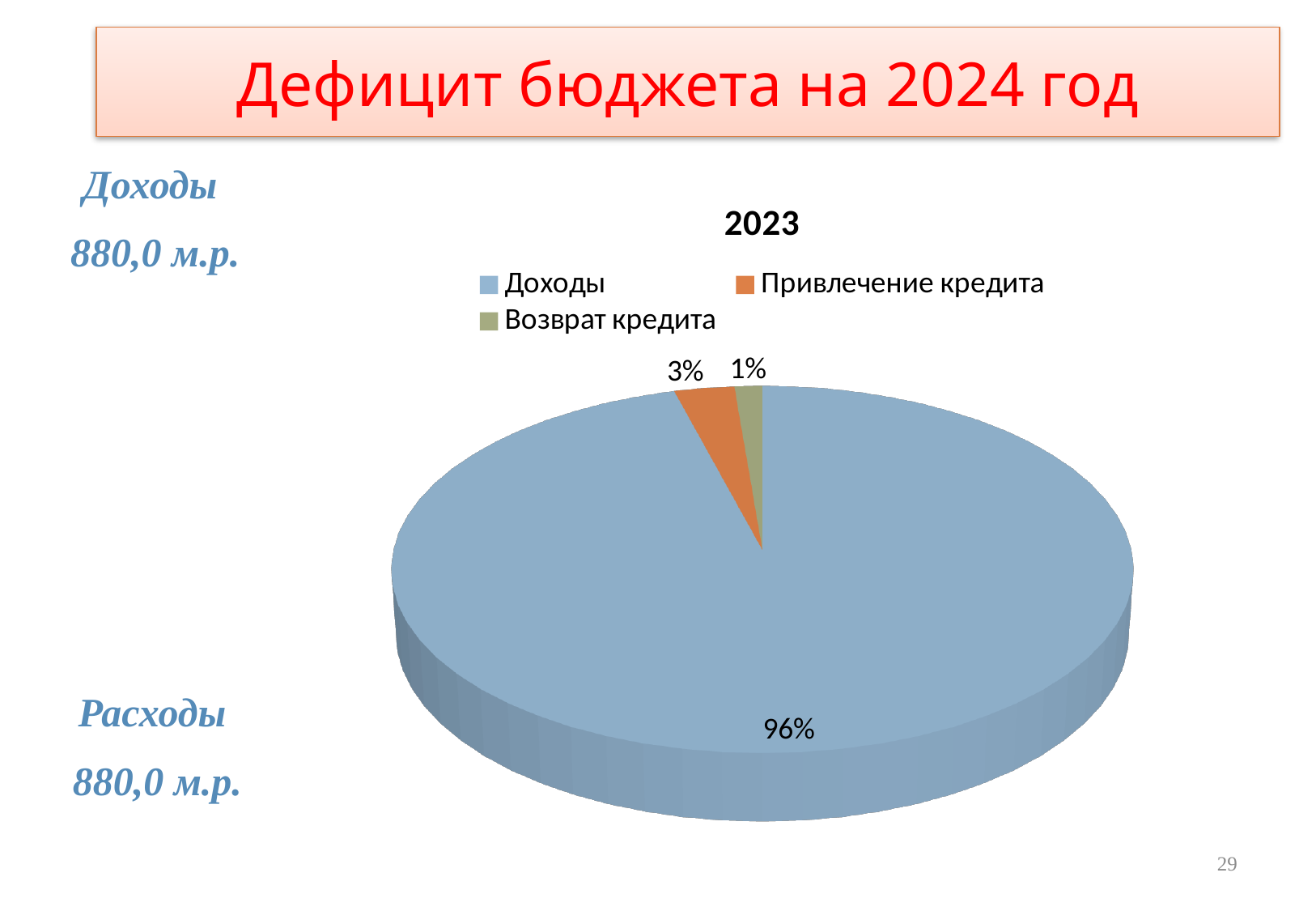
What share of the pie does Привлечение кредита take? 3% Which slice of the pie is the largest? Доходы What share of the pie does Доходы take? 96% How many slices does the pie chart have? 3 What is the title of the chart? 2023 Which slice of the pie is the smallest? Возврат кредита What is the difference in percentage points between the Доходы slice and the Привлечение кредита slice? 93 Which is larger, the slice for Привлечение кредита or the slice for Возврат кредита? Привлечение кредита What colour is the Доходы slice in the pie chart? blue What kind of chart is shown on the slide? pie chart What share of the pie does Возврат кредита take? 1% How many entries does the chart legend list? 3